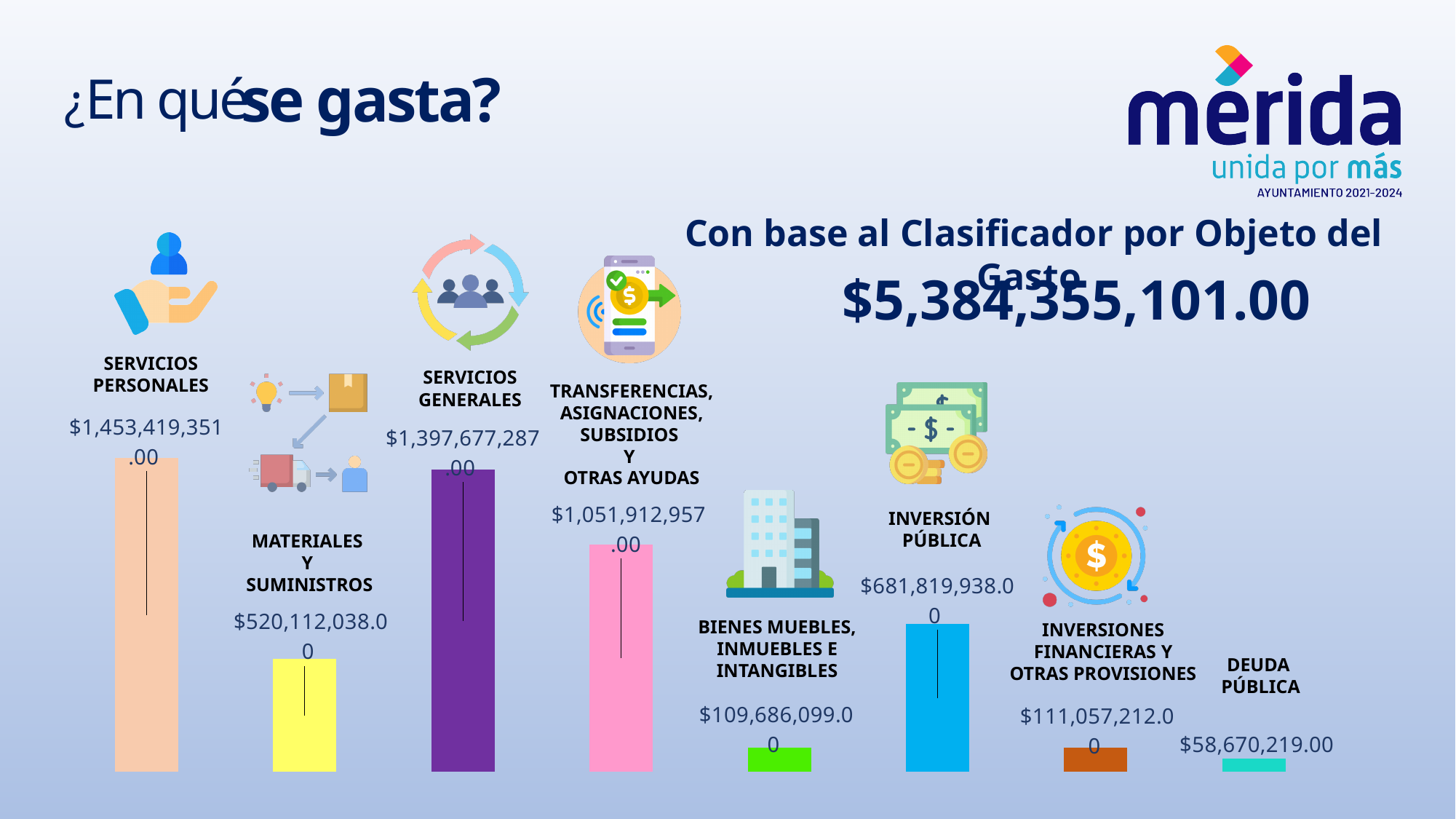
What is the difference between Servicios Personales and Servicios Generales? $55,742,064.00 What is the difference between Materiales y Suministros and Deuda Pública? $461,441,819.00 What is the value shown for Inversión Pública? $681,819,938.00 Which category has the lowest value? Deuda Pública What is the value shown for Deuda Pública? $58,670,219.00 Which is larger, Inversiones Financieras y Otras Provisiones or Bienes Muebles, Inmuebles e Intangibles? Inversiones Financieras y Otras Provisiones What kind of chart is shown on the slide? Bar chart What is the value shown for Transferencias, Asignaciones, Subsidios y Otras Ayudas? $1,051,912,957.00 What colour is the bar for Servicios Generales? Purple How many categories are shown in the chart? 8 Which category has the highest value? Servicios Personales What is the value shown for Servicios Personales? $1,453,419,351.00